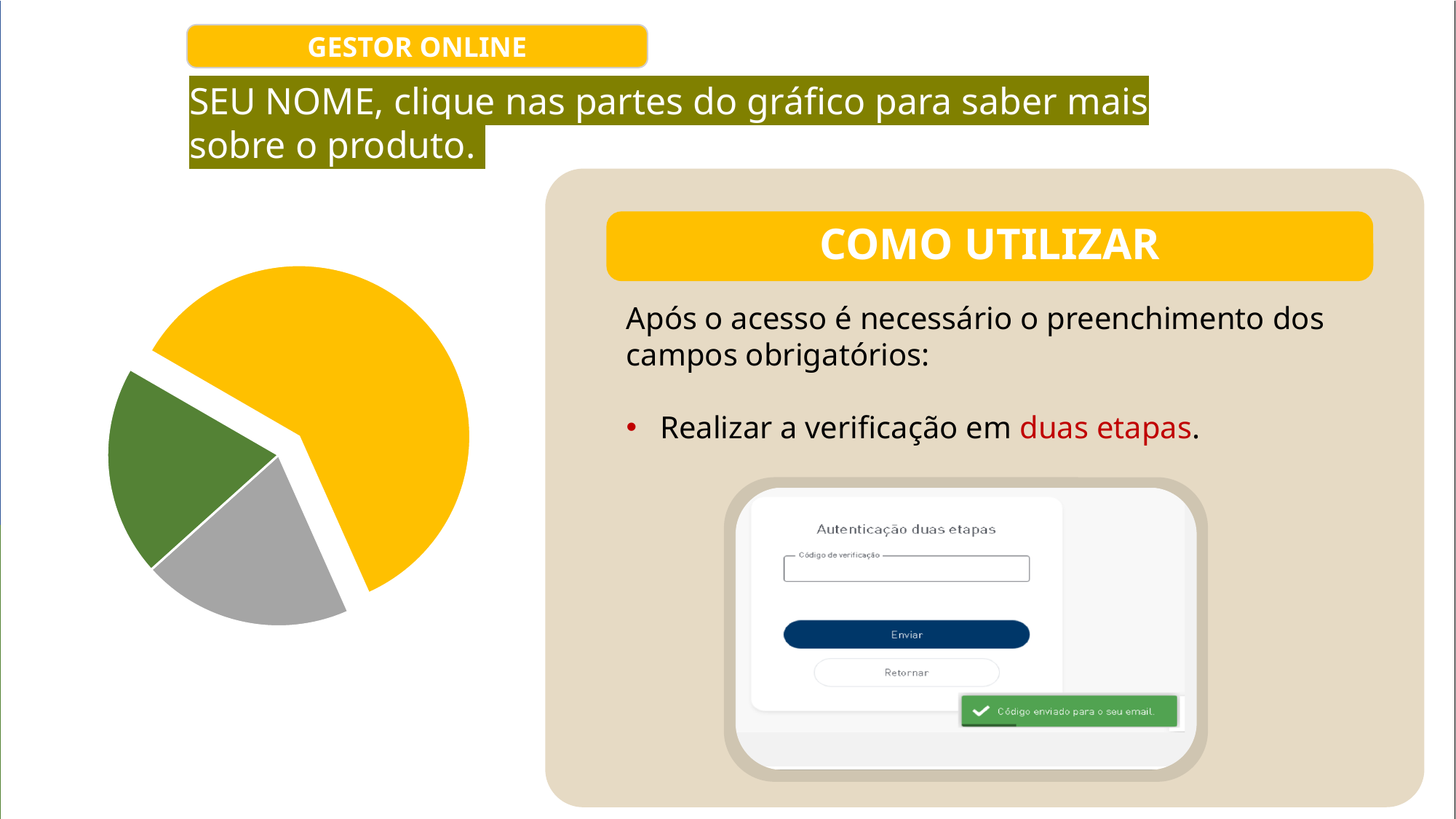
How many slices does the pie chart on the left of the slide have? 3 What three colours are used for the slices of the pie chart on the left of the slide? yellow, green and gray In the pie chart on the left of the slide, which is larger, the yellow slice or the green slice? the yellow slice What kind of chart is shown on the left of the slide? pie chart In the pie chart on the left of the slide, which is larger, the yellow slice or the gray slice? the yellow slice Does the pie chart on the left of the slide show a legend? No Which colour slice is the largest in the pie chart on the left of the slide? yellow